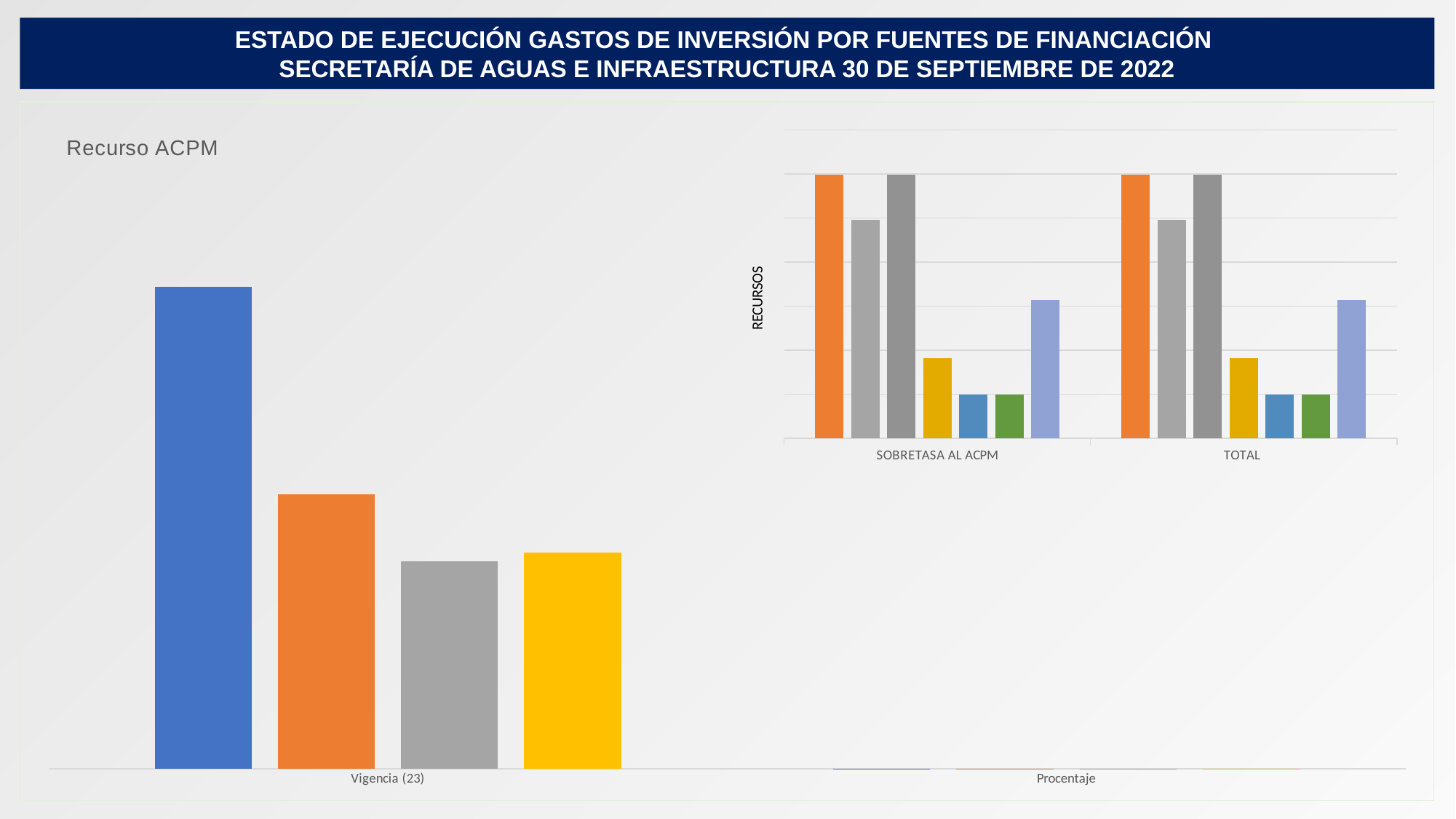
In the 'Recurso ACPM' chart on the left, for Vigencia (23), is the blue bar or the orange bar taller? the blue bar What kind of chart is the chart on the right of the slide? bar chart What is the title of the chart on the left of the slide? Recurso ACPM In the 'Recurso ACPM' chart on the left, which coloured bar is the tallest for Vigencia (23)? the blue bar In the 'Recurso ACPM' chart on the left, which category has the tallest bars, Vigencia (23) or Procentaje? Vigencia (23) How many categories are shown on the x axis of the chart on the right? 2 What is the label on the vertical axis of the chart on the right? RECURSOS In the chart on the right, how many bars are plotted for the category SOBRETASA AL ACPM? 7 In the chart on the right, for TOTAL, is the light grey bar or the yellow bar taller? the light grey bar What kind of chart is the 'Recurso ACPM' chart on the left? bar chart How many categories are shown on the x axis of the 'Recurso ACPM' chart on the left? 2